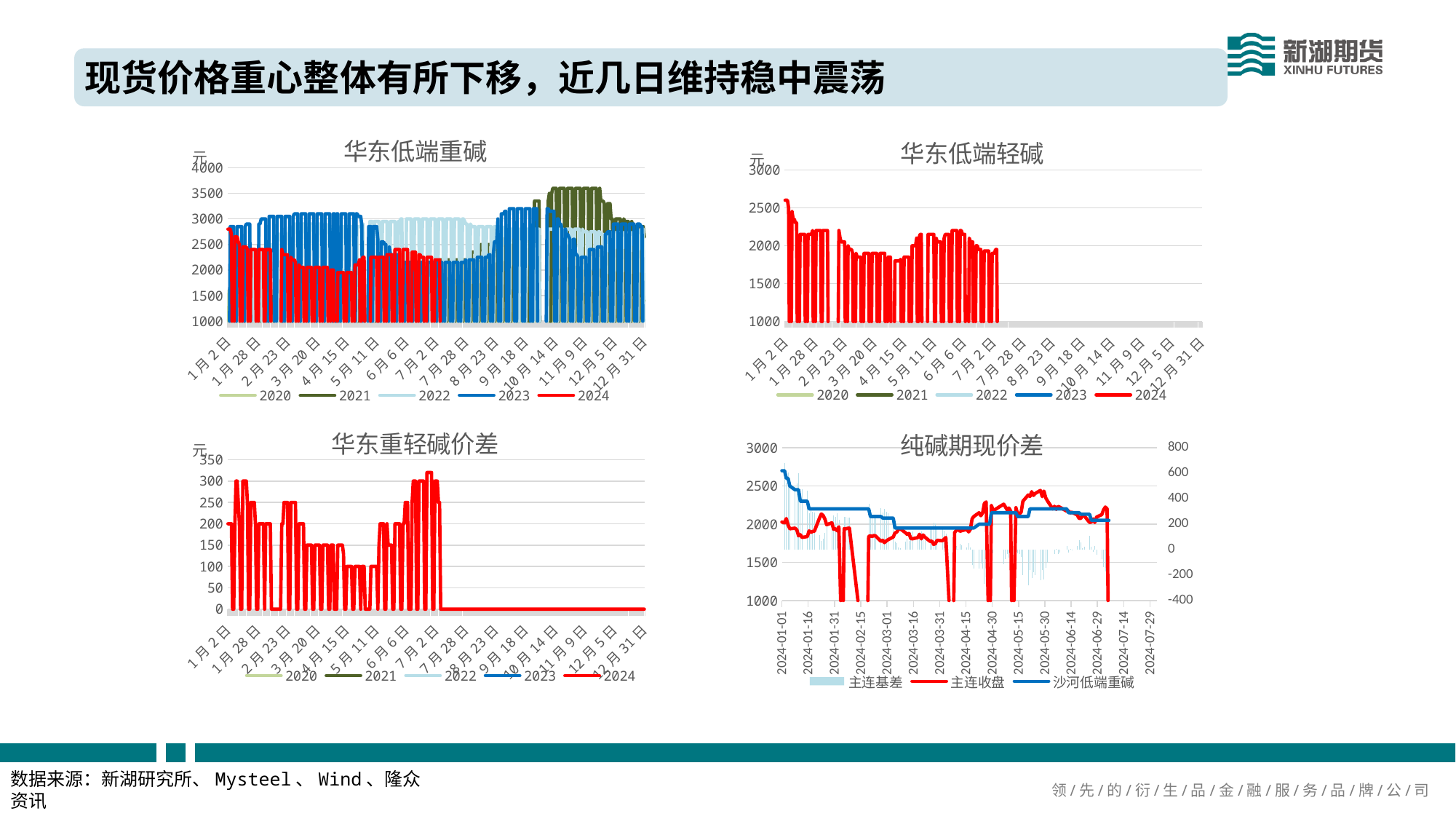
In the 纯碱期现价差 chart, does the 沙河低端重碱 line rise or fall from 2024-01-01 to 2024-03-01? fall In the 华东低端轻碱 chart, does the 2024 series rise or fall from 1月2日 to 2月23日? fall Which series in the 纯碱期现价差 chart is plotted as bars rather than a line? 主连基差 In the 华东低端轻碱 chart, is the 2024 value at 1月2日 greater or less than 2000? greater In the 华东低端重碱 chart, is the highest value of the 2021 series greater or less than 3000? greater How many series does the legend of the 华东低端重碱 chart list? 5 In the 纯碱期现价差 chart, is the 沙河低端重碱 value at 2024-01-01 greater or less than 2500 on the left axis? greater What is the title of the chart in the bottom-left of the slide? 华东重轻碱价差 How many series does the legend of the 纯碱期现价差 chart list? 3 What kind of chart is the 华东低端轻碱 chart? Line chart